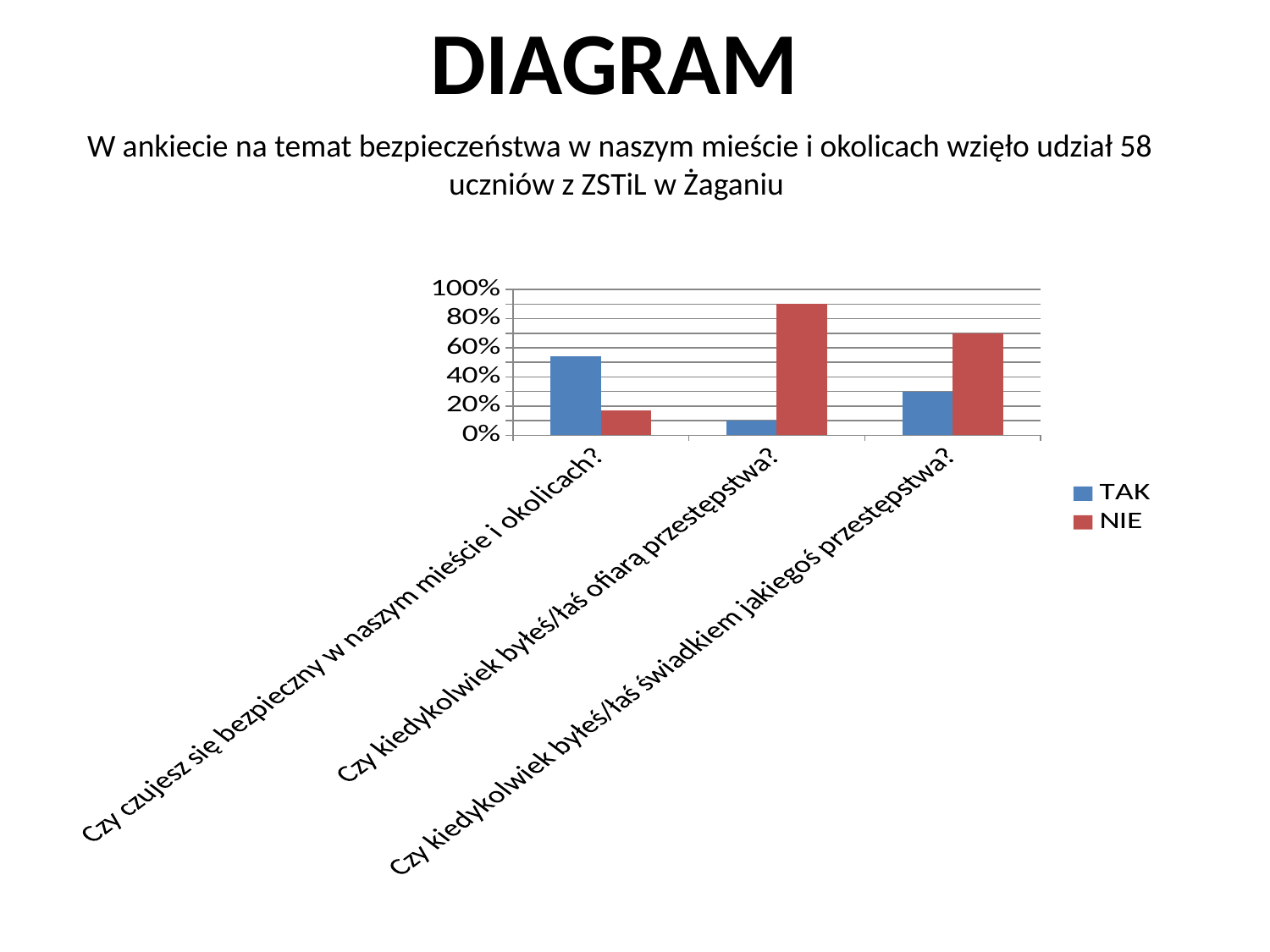
For the question "Czy czujesz się bezpieczny w naszym mieście i okolicach?", which is larger, TAK or NIE? TAK Is the TAK value for "Czy kiedykolwiek byłeś/łaś świadkiem jakiegoś przestępstwa?" greater or less than 40%? less For which question is the TAK value the lowest? Czy kiedykolwiek byłeś/łaś ofiarą przestępstwa? For which question is the NIE value the highest? Czy kiedykolwiek byłeś/łaś ofiarą przestępstwa? What kind of chart is shown on the slide? bar chart For the question "Czy kiedykolwiek byłeś/łaś ofiarą przestępstwa?", which is larger, TAK or NIE? NIE Is the TAK value for "Czy czujesz się bezpieczny w naszym mieście i okolicach?" greater or less than 40%? greater How many series does the legend list? 2 Which series is shown in blue in the chart? TAK How many questions (categories) are shown on the x axis of the chart? 3 For the question "Czy kiedykolwiek byłeś/łaś świadkiem jakiegoś przestępstwa?", which is larger, TAK or NIE? NIE Is the NIE value for "Czy kiedykolwiek byłeś/łaś ofiarą przestępstwa?" greater or less than 80%? greater